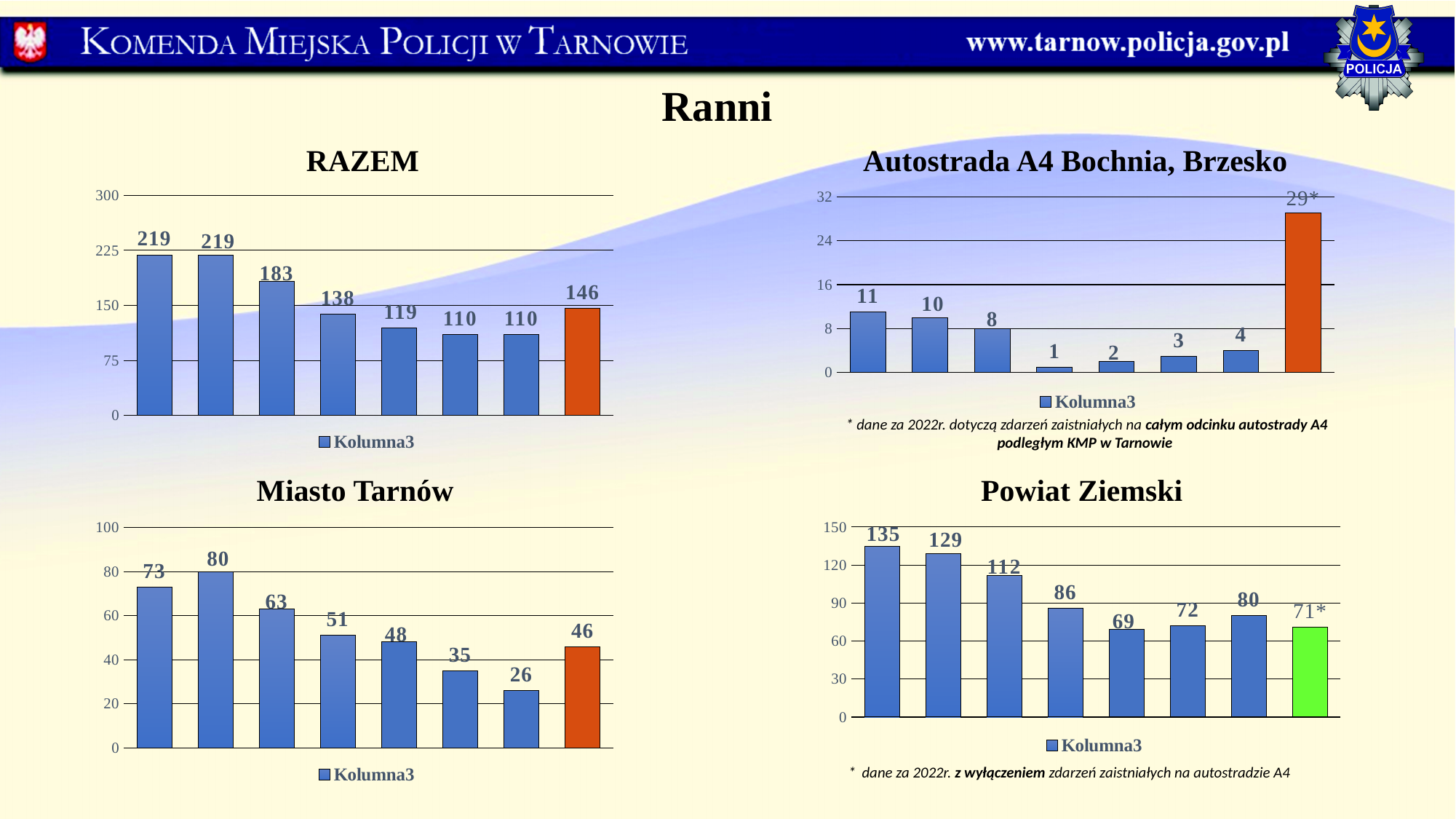
In the Powiat Ziemski chart, what is the value of the first bar? 135 How many bars are plotted in the RAZEM chart? 8 In the Miasto Tarnów chart, do the values rise or fall from the second bar to the seventh bar? fall In the Autostrada A4 Bochnia, Brzesko chart, what is the value labelled on the last (orange) bar? 29* What kind of chart is the Powiat Ziemski chart? bar chart In the Powiat Ziemski chart, what is the difference between the first bar (135) and the last bar (71)? 64 In the RAZEM chart, what is the difference between the third bar (183) and the fourth bar (138)? 45 In the Autostrada A4 Bochnia, Brzesko chart, what is the difference between the first bar (11) and the second bar (10)? 1 In the Miasto Tarnów chart, what is the highest value shown? 80 In the RAZEM chart, what is the value of the last (orange) bar? 146 In the Miasto Tarnów chart, which is larger, the first bar or the second bar? the second bar (80) In the Miasto Tarnów chart, what is the lowest value shown? 26